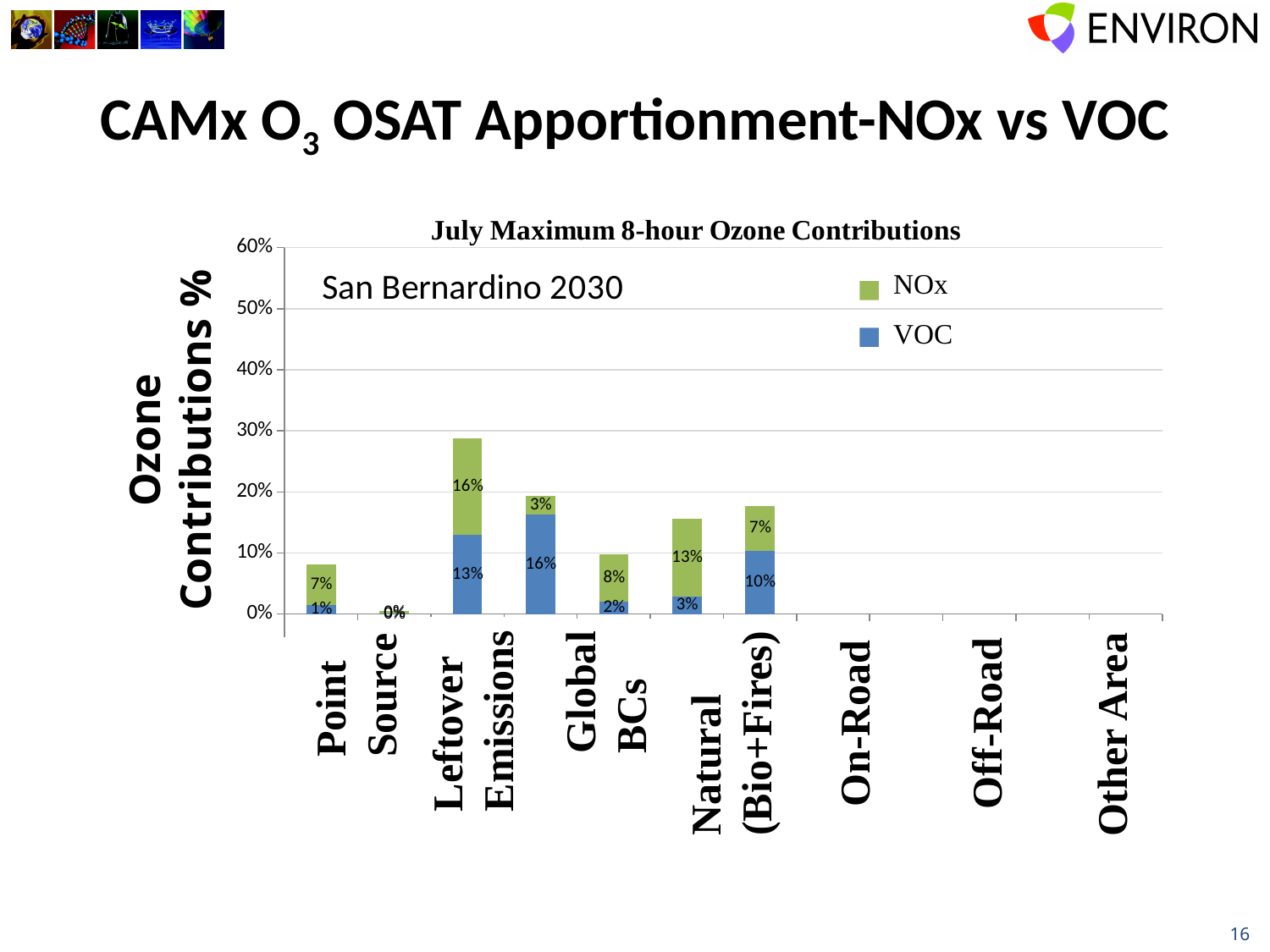
What is the total of the tallest stacked bar in the chart (VOC 13% plus NOx 16%)? 29% In the tallest stacked bar, which segment is larger: the VOC segment (13%) or the NOx segment (16%)? NOx What are the two series named in the chart legend? NOx and VOC What type of chart is shown on the slide? stacked bar chart What is the title of the chart? July Maximum 8-hour Ozone Contributions How many category labels are shown on the x-axis of the chart? 7 What is the total of the first (leftmost) stacked bar in the chart, which has VOC 1% and NOx 7%? 8% Is the tallest stacked bar in the chart greater or less than 30%? less How many series does the chart legend list? 2 What is the highest value shown on the y-axis of the chart? 60% What is the largest NOx segment value labeled on any bar in the chart? 16% What is the largest VOC segment value labeled on any bar in the chart? 16%